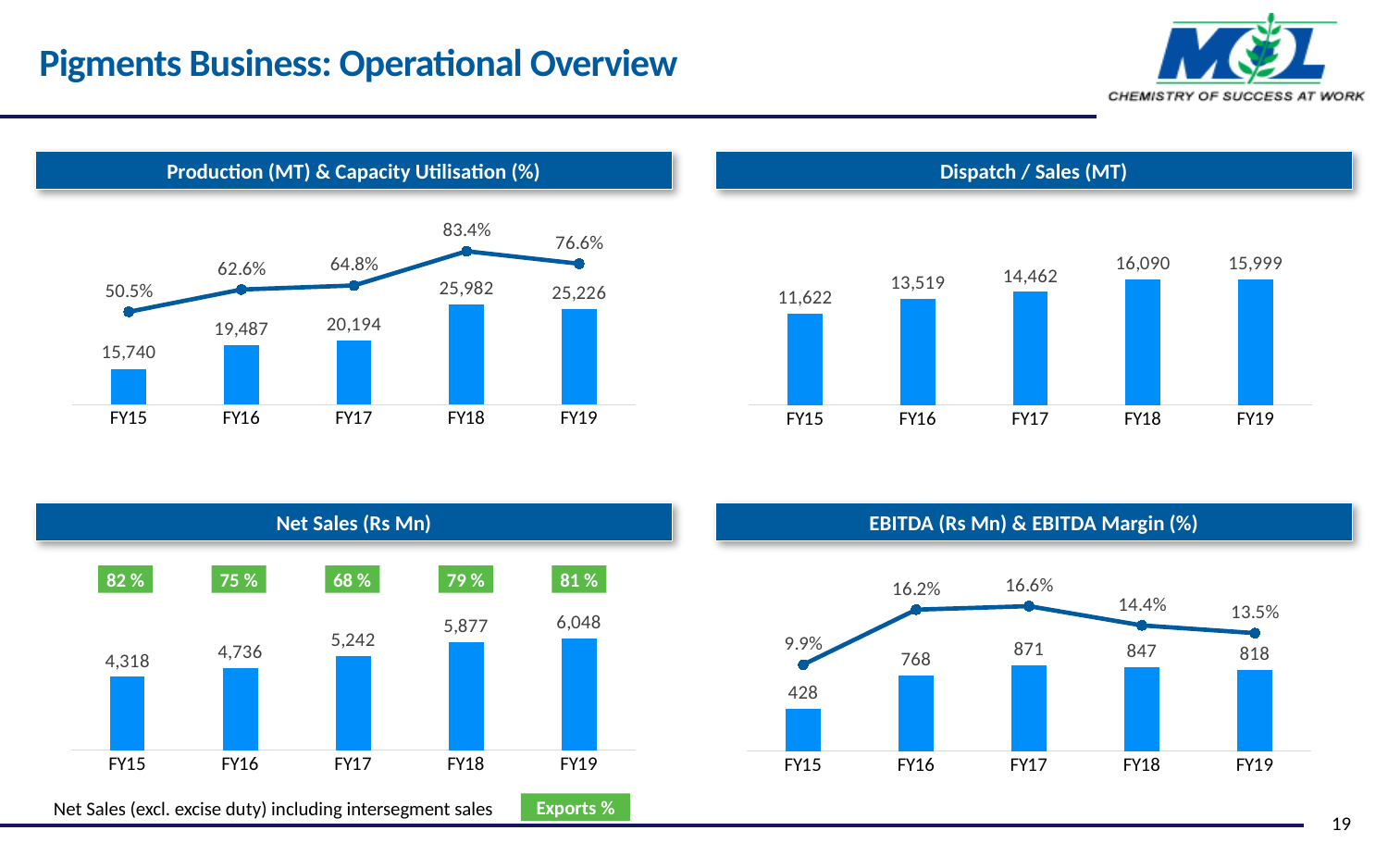
In the 'Production (MT) & Capacity Utilisation (%)' chart, what is the capacity utilisation for FY18? 83.4% How many years are shown on the x axis of the 'Dispatch / Sales (MT)' chart? 5 In the 'Net Sales (Rs Mn)' chart, do net sales rise or fall from FY15 to FY19? rise In the 'EBITDA (Rs Mn) & EBITDA Margin (%)' chart, which year has the highest EBITDA margin? FY17 In the 'EBITDA (Rs Mn) & EBITDA Margin (%)' chart, what is the EBITDA for FY17? 871 In the 'Production (MT) & Capacity Utilisation (%)' chart, what is the production value for FY17? 20,194 In the 'Net Sales (Rs Mn)' chart, what is the net sales value for FY19? 6,048 In the 'Dispatch / Sales (MT)' chart, what is the value for FY16? 13,519 In the 'Dispatch / Sales (MT)' chart, which year has the lowest value? FY15 In the 'Net Sales (Rs Mn)' chart, what is the Exports % shown for FY17? 68 % In the 'Dispatch / Sales (MT)' chart, what is the difference between the FY18 and FY17 values? 1,628 In the 'Production (MT) & Capacity Utilisation (%)' chart, which year has the highest production? FY18